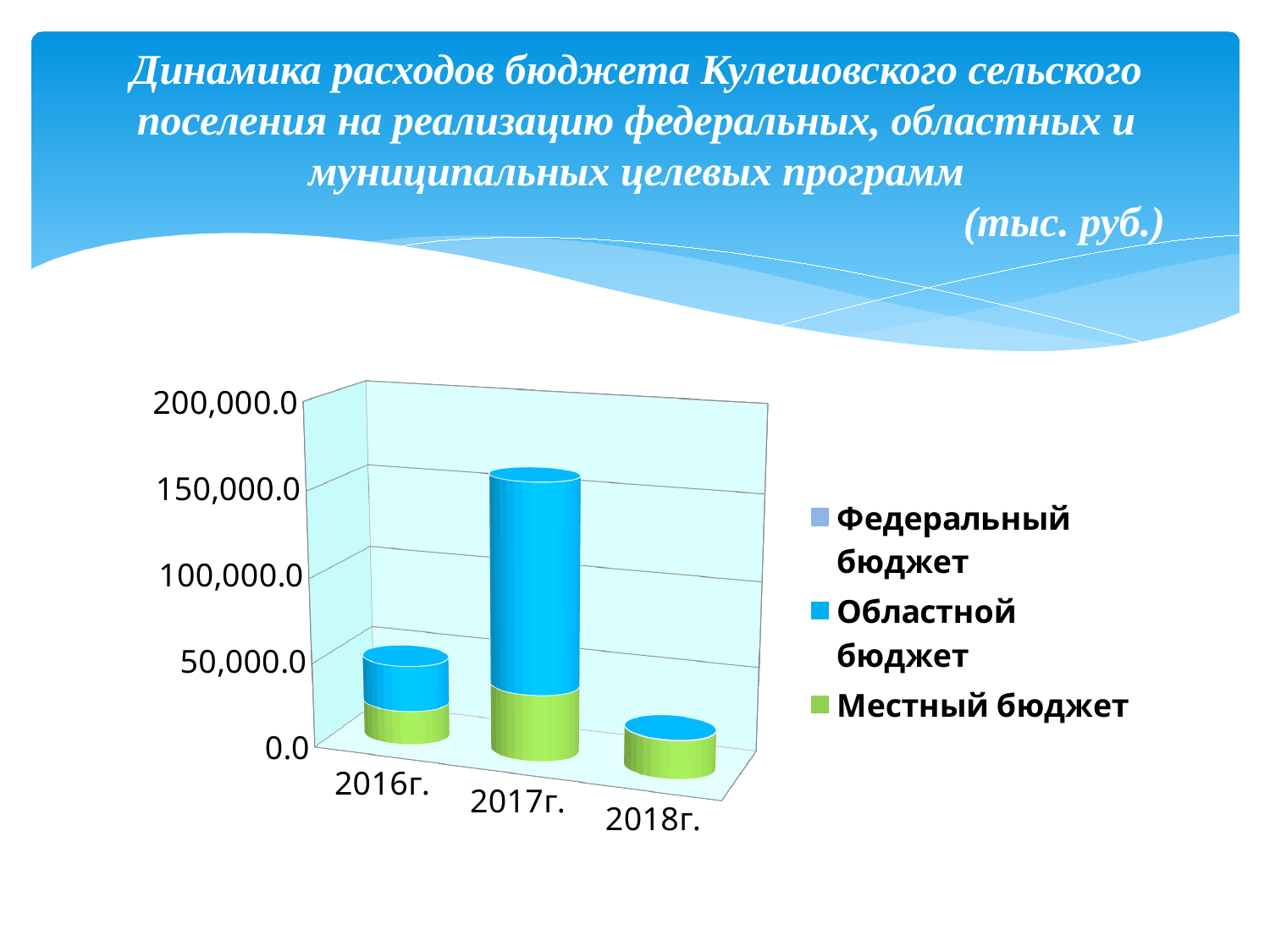
Is the total bar for 2018г. greater or less than 50,000.0? less What colour represents Местный бюджет in the chart legend? green What kind of chart is shown on the slide? bar chart How many series does the chart legend list? 3 Which year has the lowest total bar in the chart? 2018г. Which total bar is larger, 2016г. or 2017г.? 2017г. Is the total bar for 2016г. greater or less than 100,000.0? less In what units are the values in the chart expressed, according to the slide title? тыс. руб. How many years (categories) are shown on the x axis of the chart? 3 Which total bar is larger, 2016г. or 2018г.? 2016г. Is the total bar for 2017г. greater or less than 100,000.0? greater Which year has the highest total bar in the chart? 2017г.